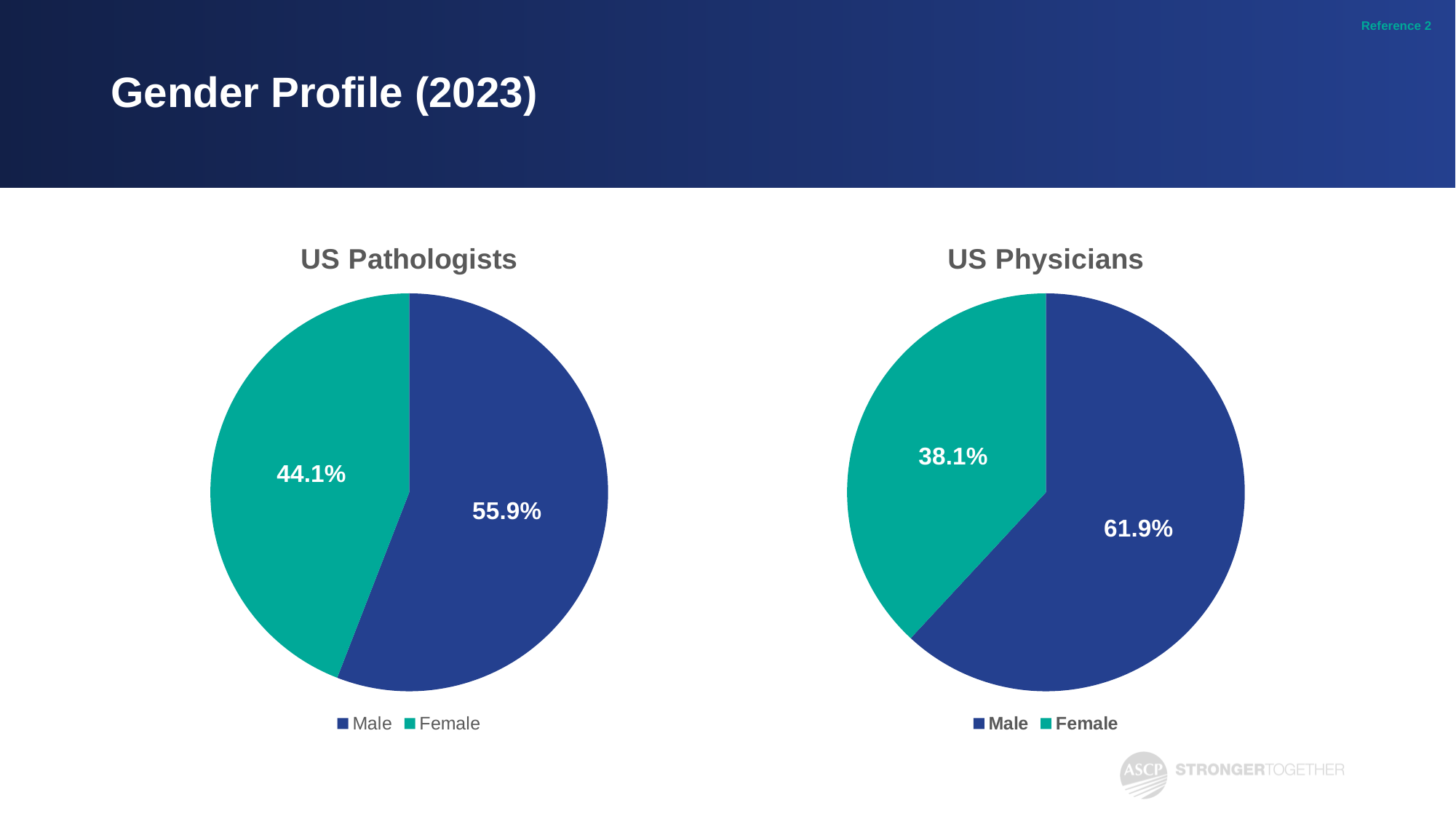
In the US Pathologists chart, what percentage is Male? 55.9% How many slices does the US Pathologists chart have? 2 In the US Physicians chart, what is the difference between the Male and Female percentages? 23.8% What type of chart is the US Physicians chart? Pie chart In the US Physicians chart, what percentage is Female? 38.1% In the US Physicians chart, what percentage is Male? 61.9% In the US Physicians chart, which slice is the smallest? Female In the US Pathologists chart, which slice is the largest? Male Which chart has the larger Female share, US Pathologists or US Physicians? US Pathologists In the US Physicians chart, what colour is the Female slice? Teal In the US Pathologists chart, what percentage is Female? 44.1% In the US Pathologists chart, what is the difference between the Male and Female percentages? 11.8%